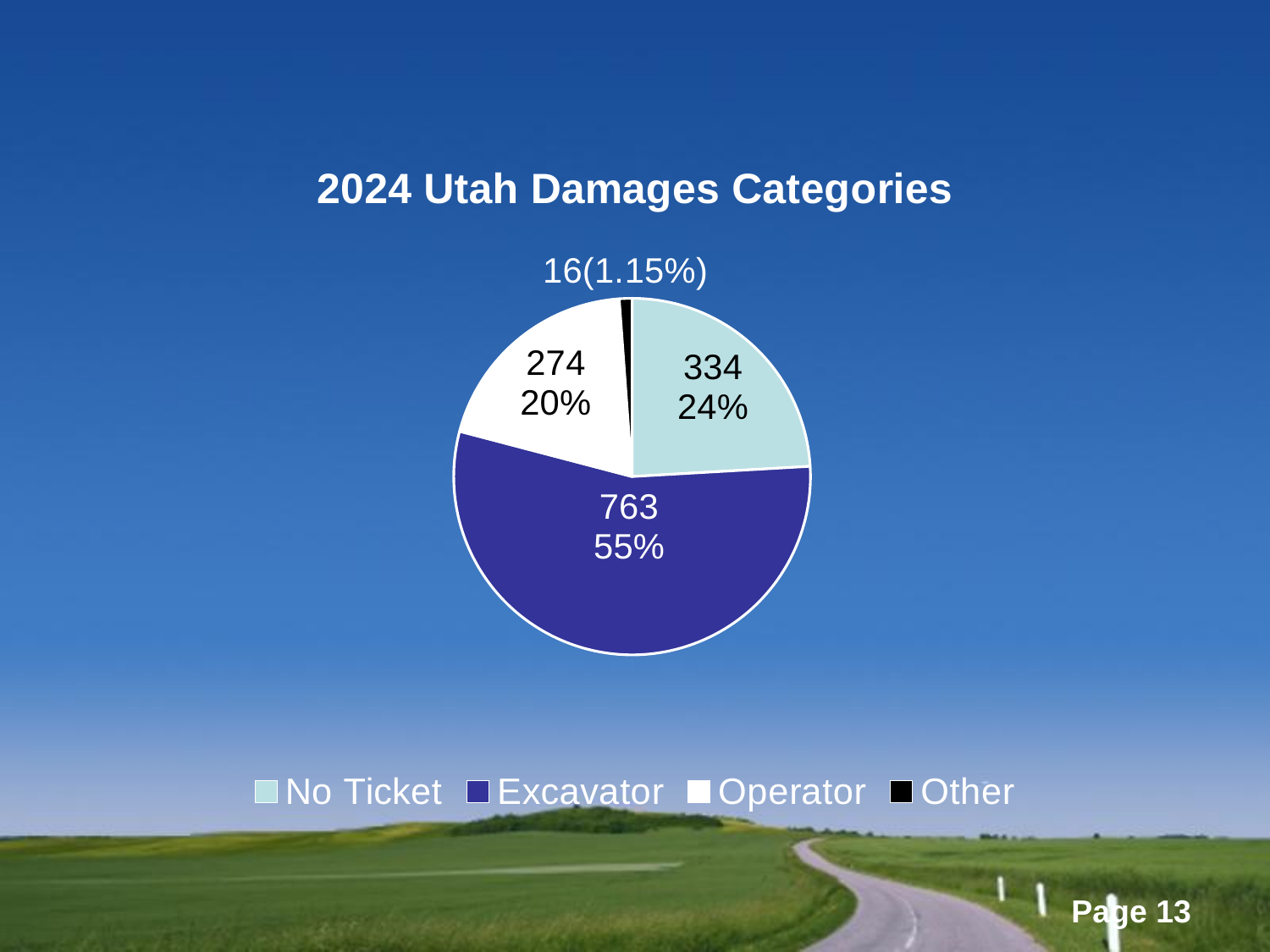
Which category has the smallest slice? Other What is the value for Excavator? 763 What is the value for No Ticket? 334 How many categories does the legend list? 4 What kind of chart is shown on the slide? pie chart What is the title of the chart? 2024 Utah Damages Categories What is the value for Operator? 274 Which category has the largest slice? Excavator What share of the pie does Excavator represent? 55% What share of the pie does No Ticket represent? 24% What is the difference between the Excavator value and the No Ticket value? 429 What is the value for Other? 16